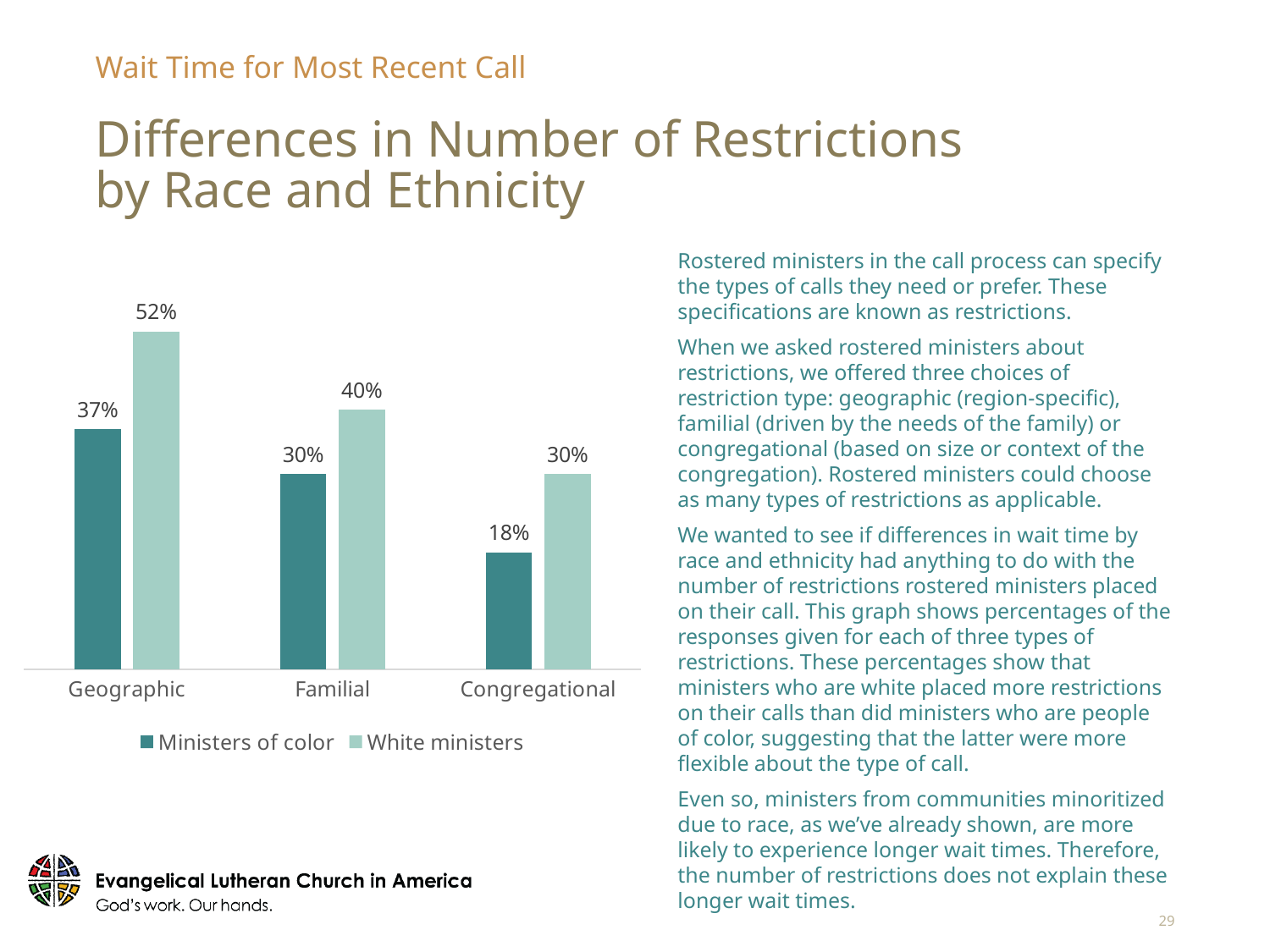
What percentage of ministers of color placed a geographic restriction? 37% What percentage of white ministers placed a familial restriction? 40% How many restriction types are shown on the x axis? 3 What is the difference between white ministers and ministers of color for the geographic restriction? 15% What is the difference between white ministers and ministers of color for the congregational restriction? 12% What kind of chart is shown on the slide? Bar chart Which restriction type has the lowest value for ministers of color? Congregational What percentage of ministers of color placed a congregational restriction? 18% Which is larger: the familial value for white ministers or the familial value for ministers of color? White ministers Which restriction type has the highest value for white ministers? Geographic How many series does the legend list? 2 Do the values for ministers of color rise or fall from Geographic to Congregational? Fall